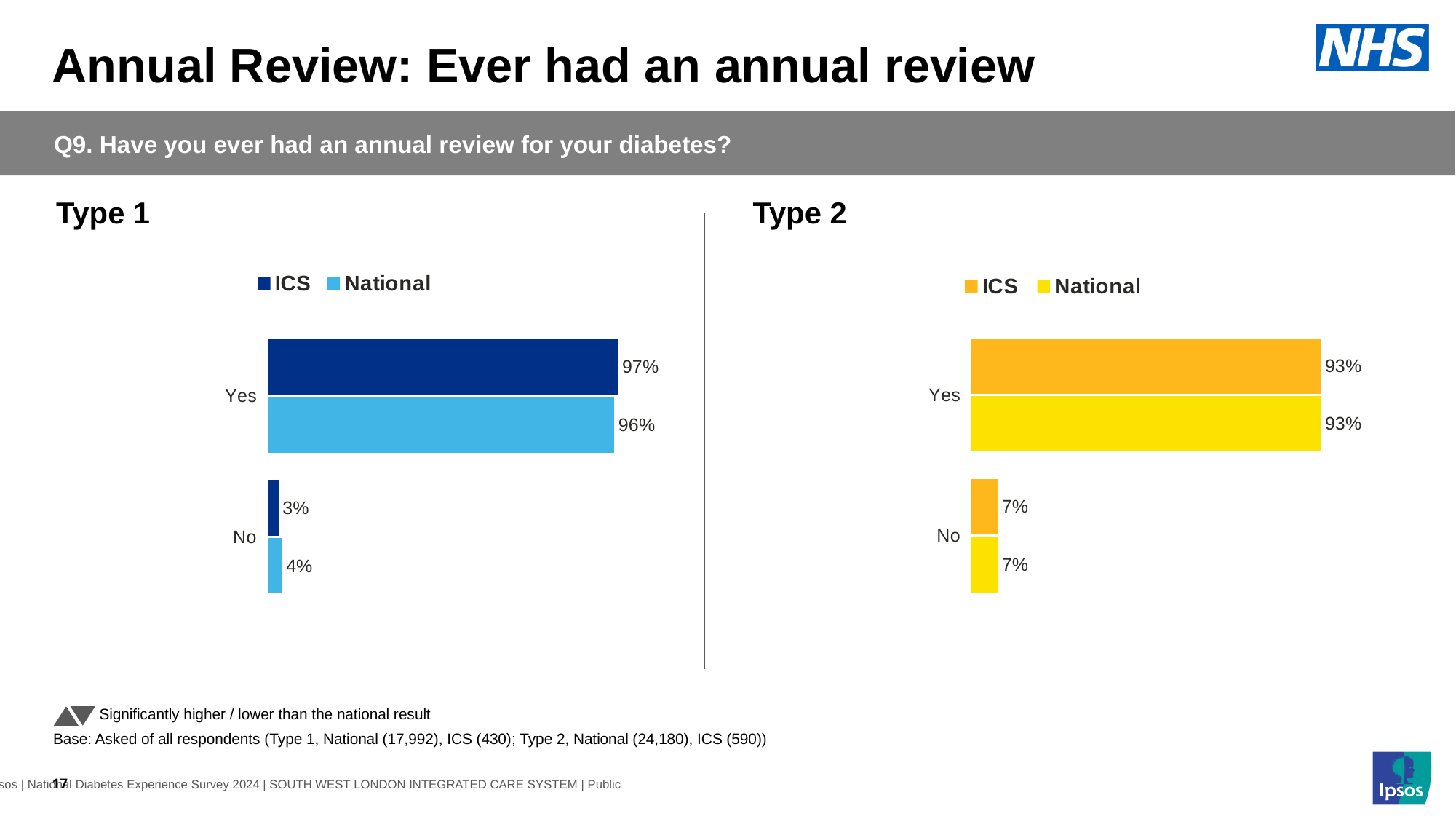
In the Type 1 chart, which category has the highest ICS value? Yes How many series does the legend of the Type 2 chart list? 2 In the Type 2 chart, what is the National value for No? 7% What kind of chart is the Type 2 chart? bar chart In the Type 1 chart, is the ICS value for No larger or smaller than the National value for No? smaller In the Type 2 chart, which category has the lowest National value? No In the Type 2 chart, what is the ICS value for Yes? 93% In the Type 1 chart, what is the National value for No? 4% In the Type 1 chart, what is the ICS value for Yes? 97% How many categories are shown in the Type 1 chart? 2 In the Type 2 chart, what is the difference between the ICS and National values for No? 0% In the Type 1 chart, what is the difference between the ICS and National values for Yes? 1%